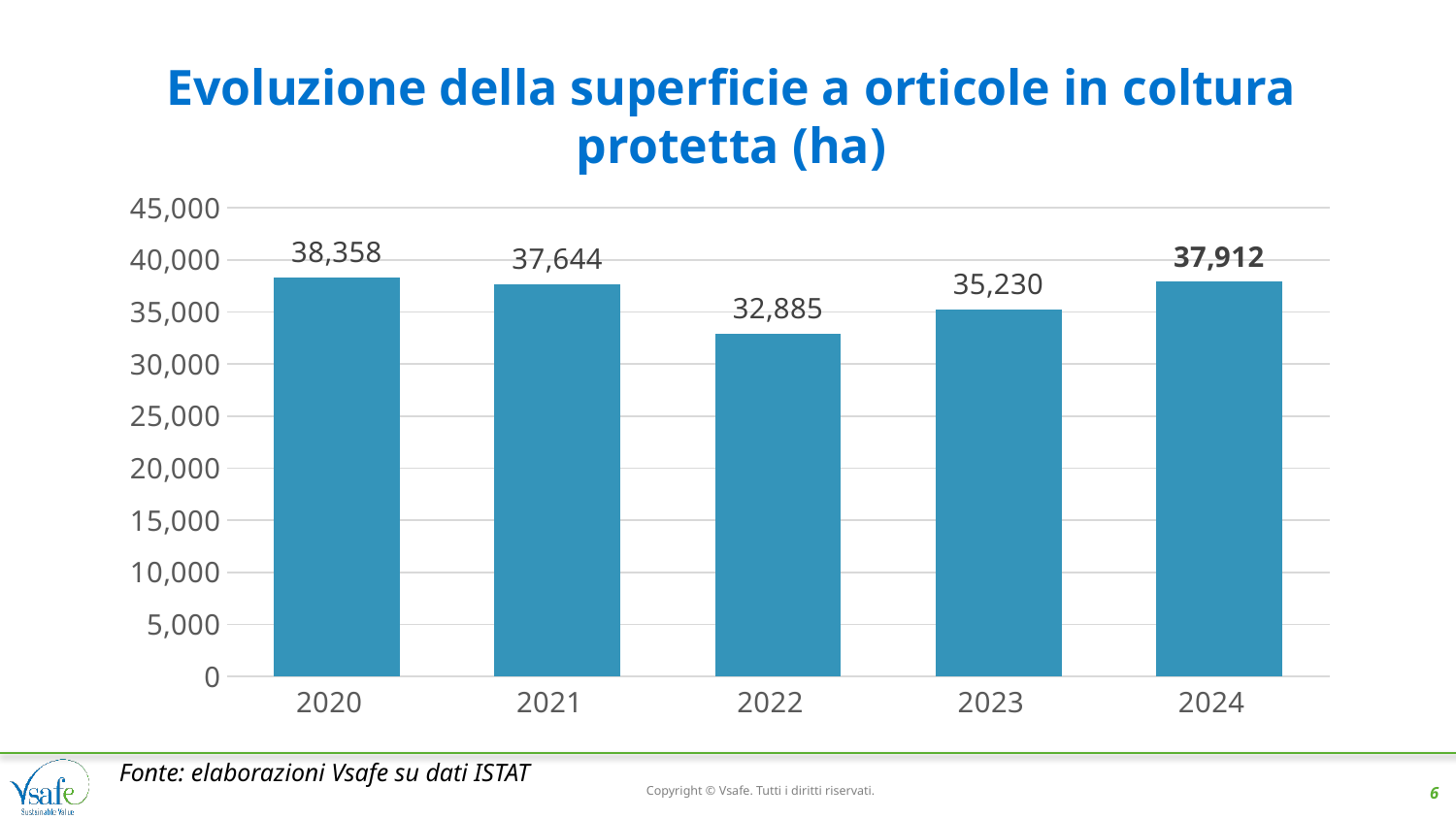
What is the value for 2020? 38,358 What kind of chart is shown on the slide? Bar chart What is the difference between the values for 2020 and 2022? 5,473 Which year has the highest value? 2020 What is the difference between the values for 2024 and 2023? 2,682 Which is larger, the value for 2021 or the value for 2024? 2024 Does the value rise or fall from 2022 to 2024? Rise What is the value for 2024? 37,912 Is the value for 2023 greater or less than 30,000? greater Which year has the lowest value? 2022 How many years are shown on the x axis? 5 What is the value for 2022? 32,885